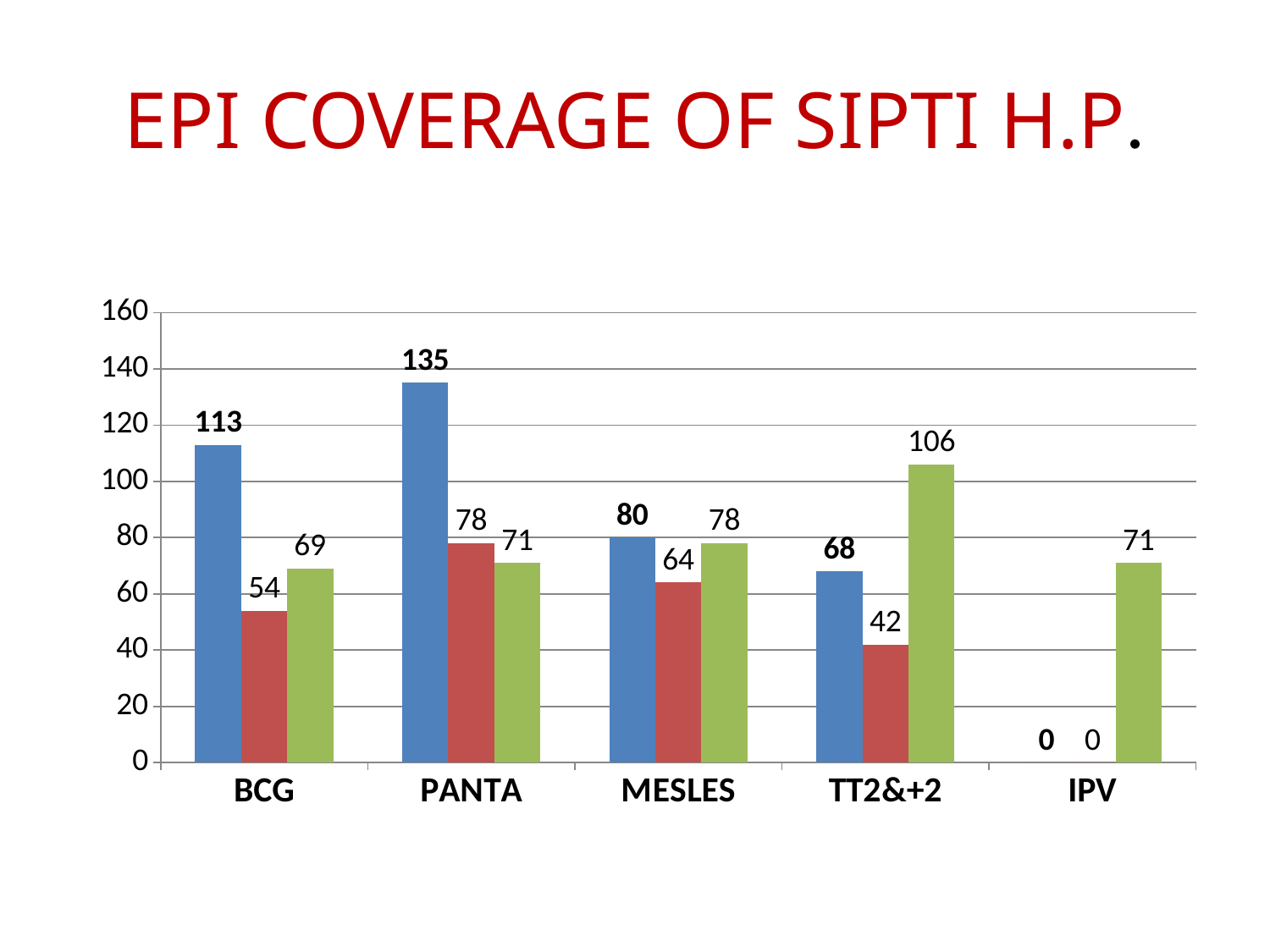
Which category has the lowest green bar? BCG What is the value of the green bar for IPV? 71 What is the value of the blue bar for PANTA? 135 Which category has the highest blue bar? PANTA What kind of chart is shown on the slide? bar chart What is the value of the red bar for TT2&+2? 42 What is the value of the blue bar for IPV? 0 How many categories are shown on the x axis? 5 What is the difference between the blue bar and the red bar for BCG? 59 What is the difference between the green bar for TT2&+2 and the green bar for MESLES? 28 Which is larger for TT2&+2, the blue bar or the green bar? the green bar What is the title of the slide? EPI COVERAGE OF SIPTI H.P.